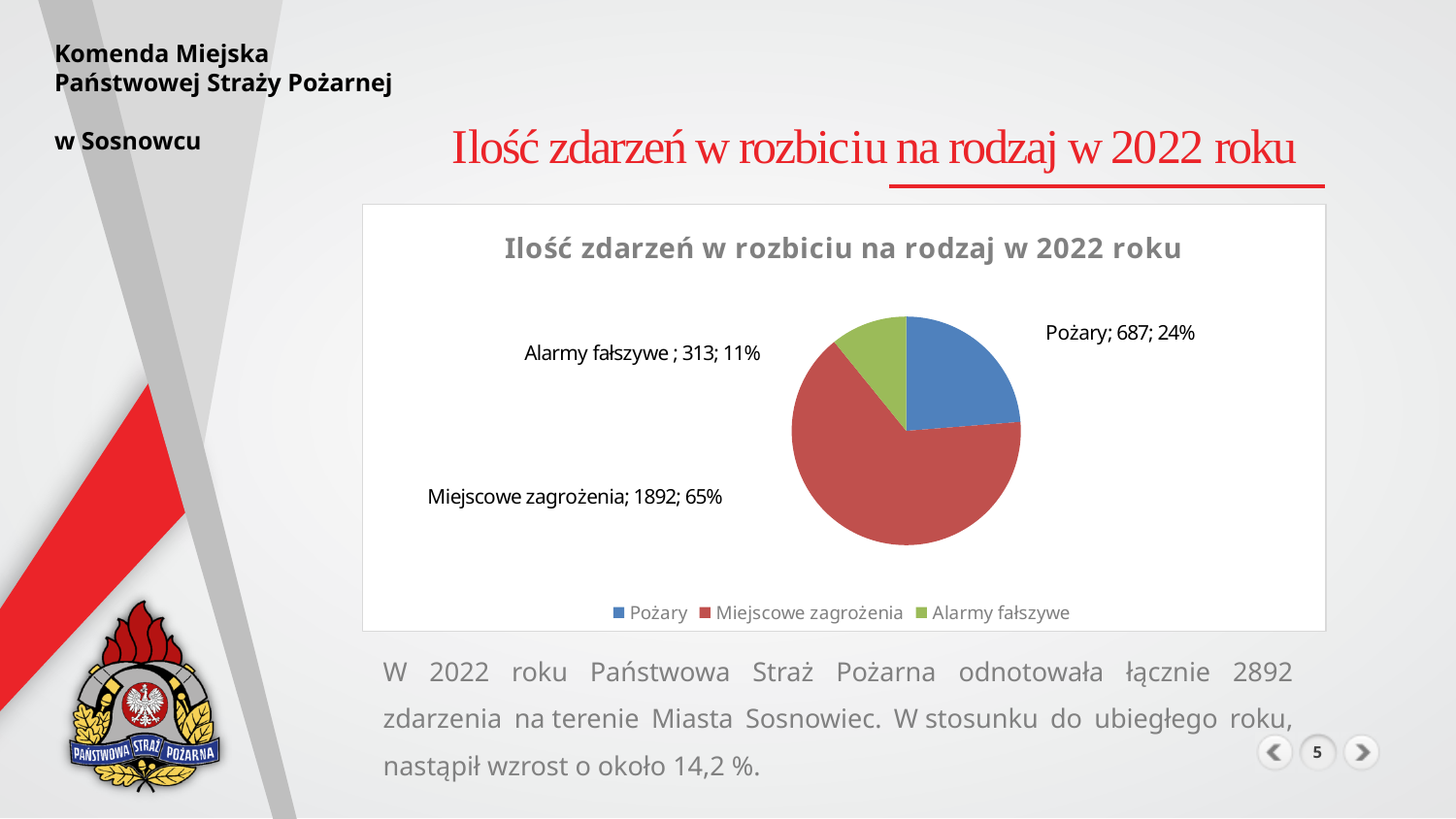
Which category has the smallest slice? Alarmy fałszywe What share of the pie does Miejscowe zagrożenia represent? 65% What is the difference between the values for Miejscowe zagrożenia and Pożary? 1205 Which is larger, the value for Pożary or the value for Alarmy fałszywe? Pożary What is the value for Pożary? 687 How many categories does the pie chart have? 3 What is the title of the chart? Ilość zdarzeń w rozbiciu na rodzaj w 2022 roku Which category has the largest slice? Miejscowe zagrożenia What share of the pie does Pożary represent? 24% What is the value for Miejscowe zagrożenia? 1892 What is the value for Alarmy fałszywe? 313 What kind of chart is shown on the slide? pie chart